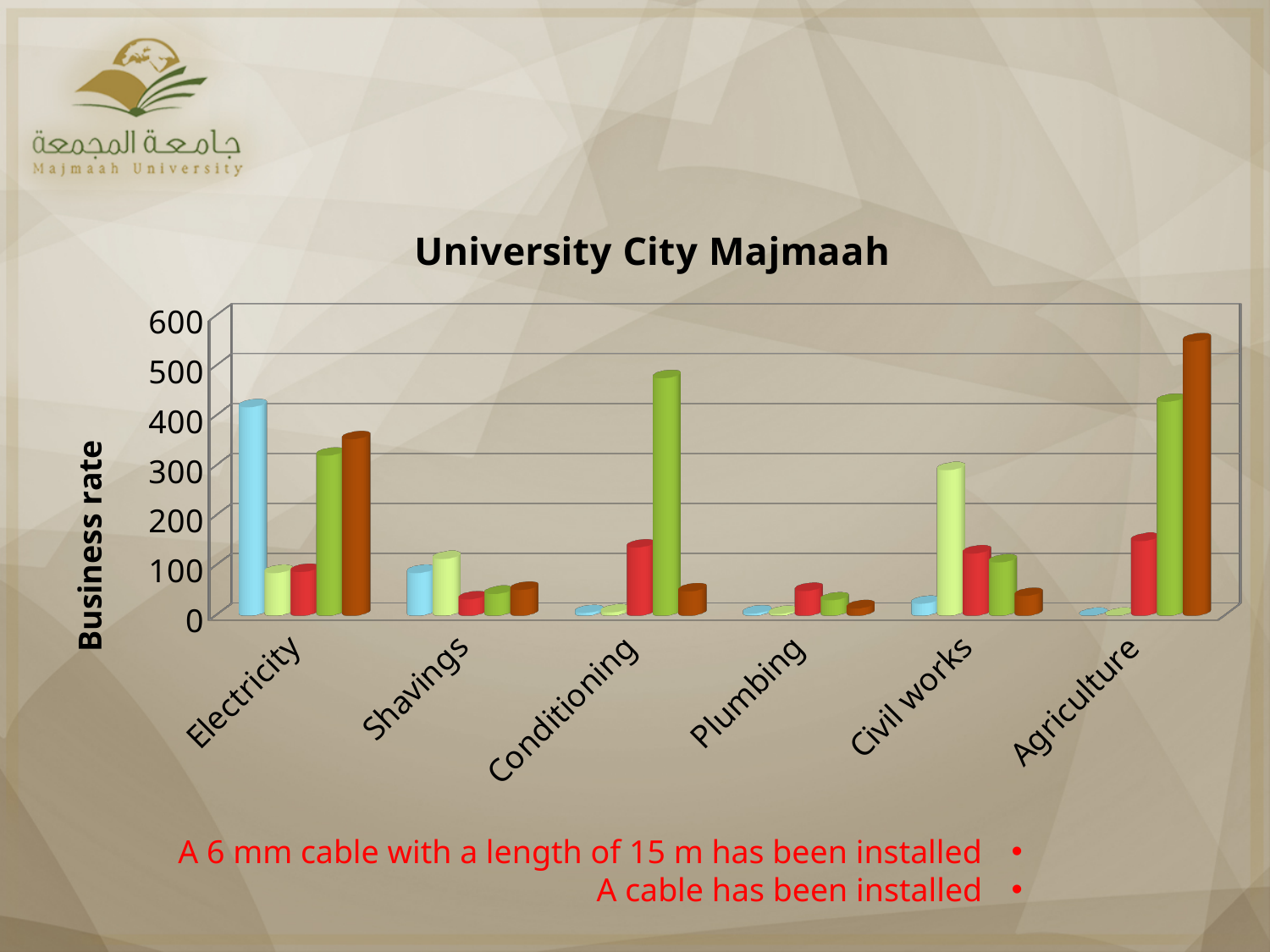
Is the value of the light blue bar for Electricity greater or less than 300? greater Is the value of the red bar for Plumbing greater or less than 100? less Which has the larger light blue bar, Electricity or Shavings? Electricity What is the title of the chart? University City Majmaah What is the label on the vertical axis of the chart? Business rate How many bars are plotted for each category in the chart? 5 Is the value of the light green bar for Civil works greater or less than 200? greater Which category contains the tallest bar in the chart? Agriculture What kind of chart is shown on the slide? bar chart How many categories are shown on the x axis of the chart? 6